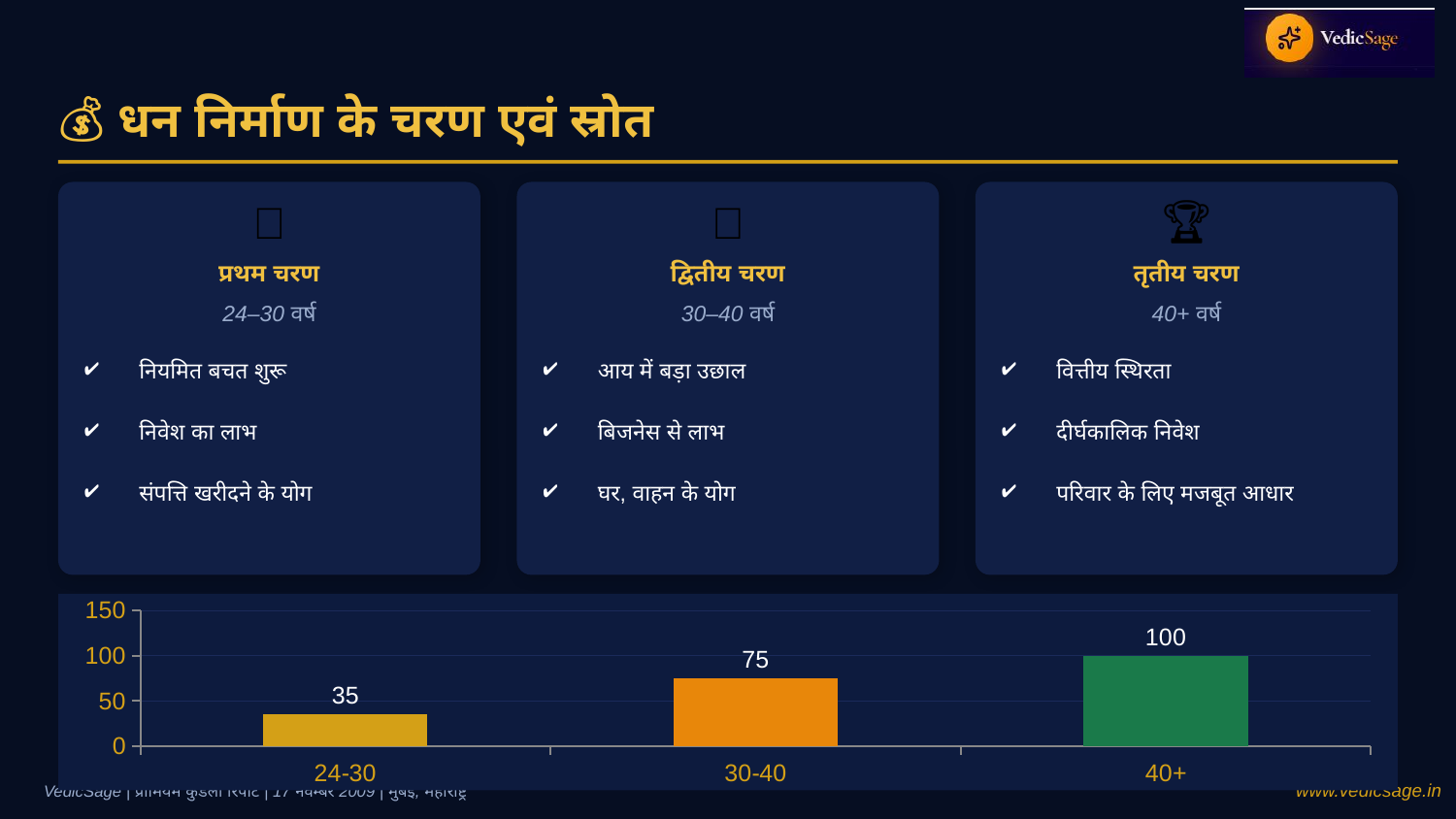
What is the difference between the values for 40+ and 24-30 in the bar chart? 65 Which is larger in the bar chart, the value for 30-40 or the value for 24-30? 30-40 What is the difference between the values for 30-40 and 24-30 in the bar chart? 40 What is the value for the 40+ category in the bar chart? 100 Is the value for 30-40 in the bar chart greater or less than 50? greater How many categories are shown on the x axis of the bar chart? 3 What is the value for the 24-30 category in the bar chart? 35 Which category has the highest value in the bar chart? 40+ What kind of chart is shown at the bottom of the slide? bar chart Do the values in the bar chart rise or fall from left to right along the x axis? rise Which category has the lowest value in the bar chart? 24-30 What is the value for the 30-40 category in the bar chart? 75